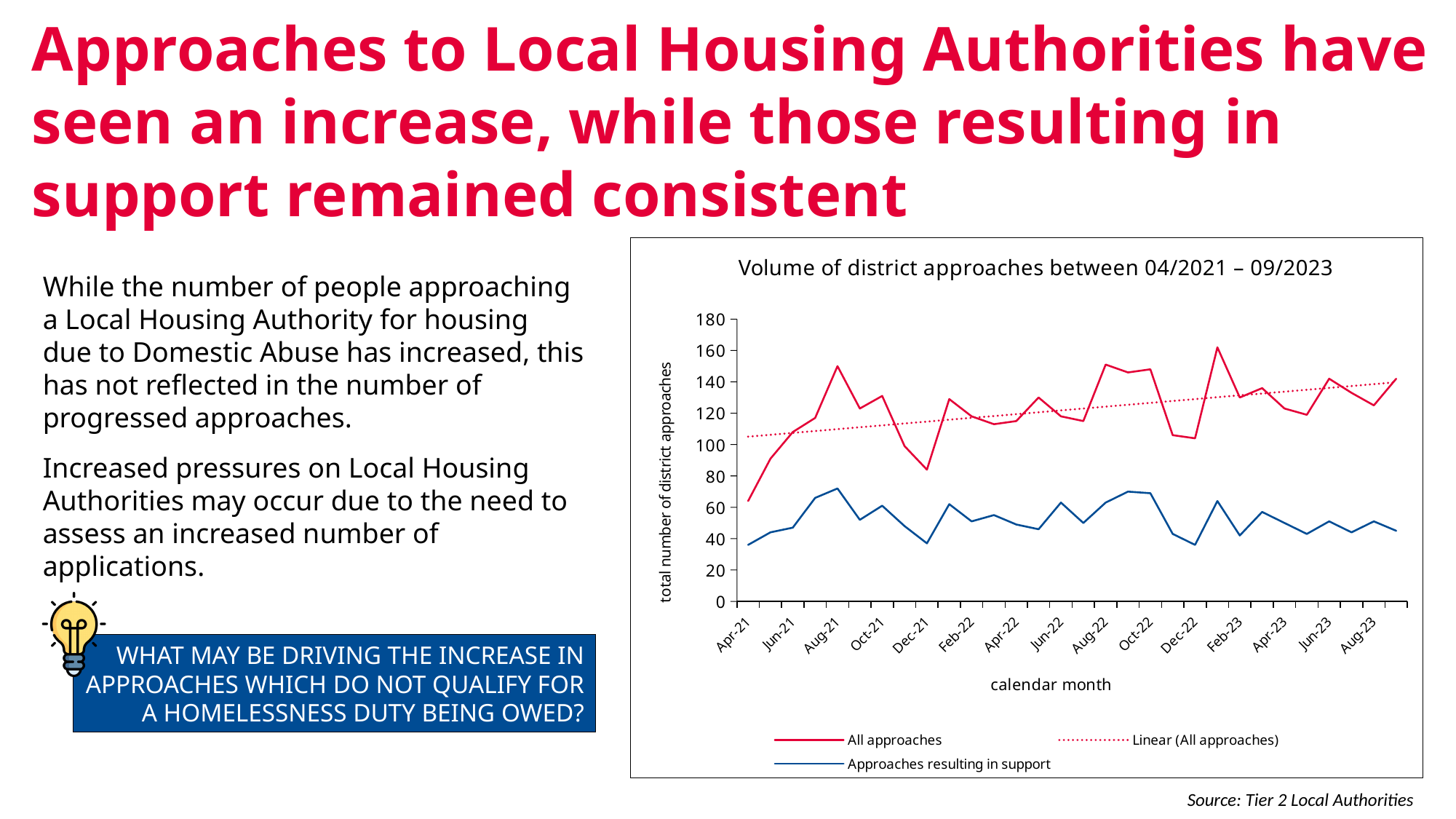
Is the value for 'Approaches resulting in support' in Aug-21 greater or less than 60? greater What is the title of the chart? Volume of district approaches between 04/2021 – 09/2023 In which month does the 'All approaches' series have its lowest value? Apr-21 How many series does the chart legend list? 3 In which month does the 'All approaches' series reach its highest value? Jan-23 Does the linear trend line for 'All approaches' rise or fall from Apr-21 to Sep-23? rise Is the value for 'All approaches' in Apr-21 greater or less than 80? less What kind of chart is shown on the slide? line chart Is the value for 'All approaches' in Jan-23 greater or less than 140? greater What is the label of the vertical axis of the chart? total number of district approaches Which series is higher in Aug-22, 'All approaches' or 'Approaches resulting in support'? All approaches